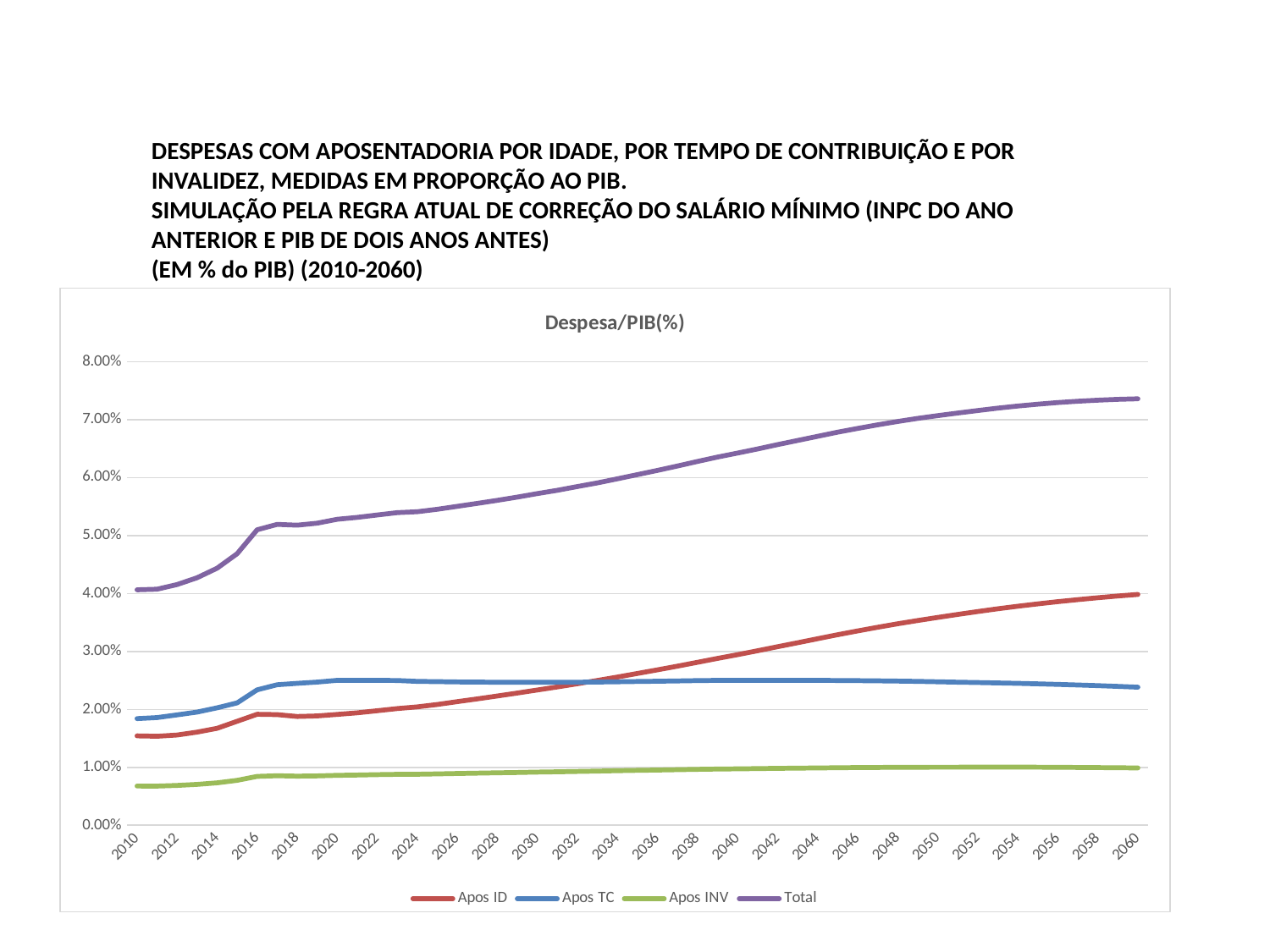
Is the value of Total in 2060 greater or less than 7.00%? greater Which series has the lowest value in 2060? Apos INV Is the value of Total in 2010 greater or less than 5.00%? less Is the value of Apos INV in 2010 greater or less than 1.00%? less Which series is plotted with the purple line? Total What kind of chart is shown on the slide? line chart In 2060, which is larger: Apos ID or Apos TC? Apos ID How many series does the legend list? 4 What is the title shown above the plot area of the chart? Despesa/PIB(%) Which series has the highest value in 2060? Total Does the Total series rise or fall from 2010 to 2060? rise